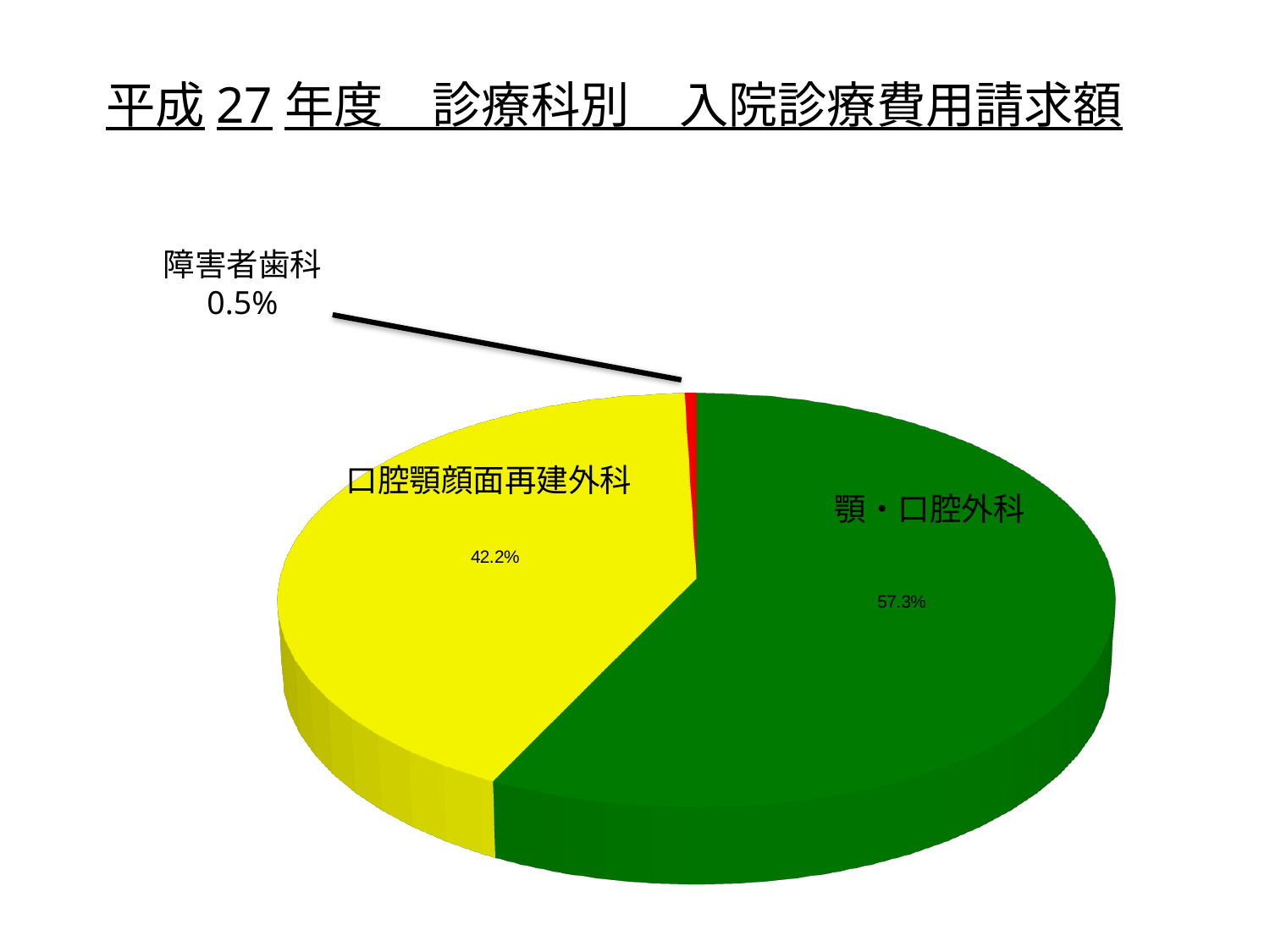
What share of the pie does 口腔顎顔面再建外科 account for? 42.2% What kind of chart is shown on the slide? Pie chart Which category has the smallest slice of the pie? 障害者歯科 Which category has the largest slice of the pie? 顎・口腔外科 What is the title of the chart on the slide? 平成27年度 診療科別 入院診療費用請求額 What is the difference in percentage points between the 顎・口腔外科 share and the 口腔顎顔面再建外科 share? 15.1 percentage points What is the difference in percentage points between the 口腔顎顔面再建外科 share and the 障害者歯科 share? 41.7 percentage points How many slices does the pie chart have? 3 What share of the pie does 障害者歯科 account for? 0.5% What colour is the slice for 口腔顎顔面再建外科? Yellow Which is larger, the share for 顎・口腔外科 or the share for 口腔顎顔面再建外科? 顎・口腔外科 What share of the pie does 顎・口腔外科 account for? 57.3%